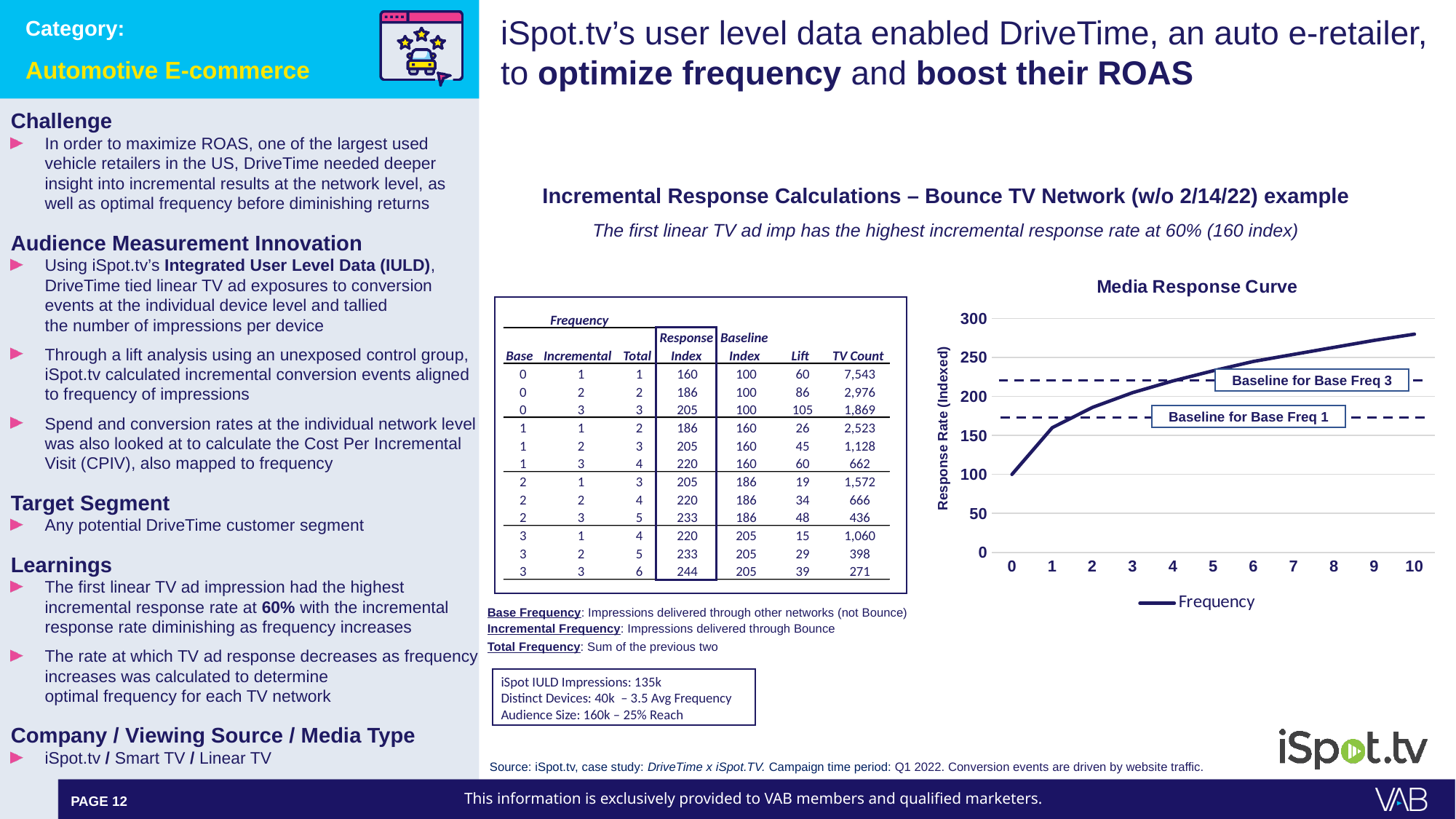
At which frequency is the response rate highest in the Media Response Curve chart? 10 What is the y-axis label of the Media Response Curve chart? Response Rate (Indexed) What is the legend entry for the line in the Media Response Curve chart? Frequency In the Media Response Curve chart, which is larger: the value at frequency 3 or the value at frequency 8? frequency 8 Does the response rate in the Media Response Curve chart rise or fall as frequency increases? rise In the Media Response Curve chart, is the value at frequency 10 greater or less than 250? greater How many series does the legend of the Media Response Curve chart list? 1 In the Media Response Curve chart, is the value at frequency 1 greater or less than 200? less In the Media Response Curve chart, is the value at frequency 5 greater or less than 200? greater At which frequency is the response rate lowest in the Media Response Curve chart? 0 What kind of chart is the Media Response Curve? line chart In the Media Response Curve chart, what is the indexed response rate at frequency 0? 100